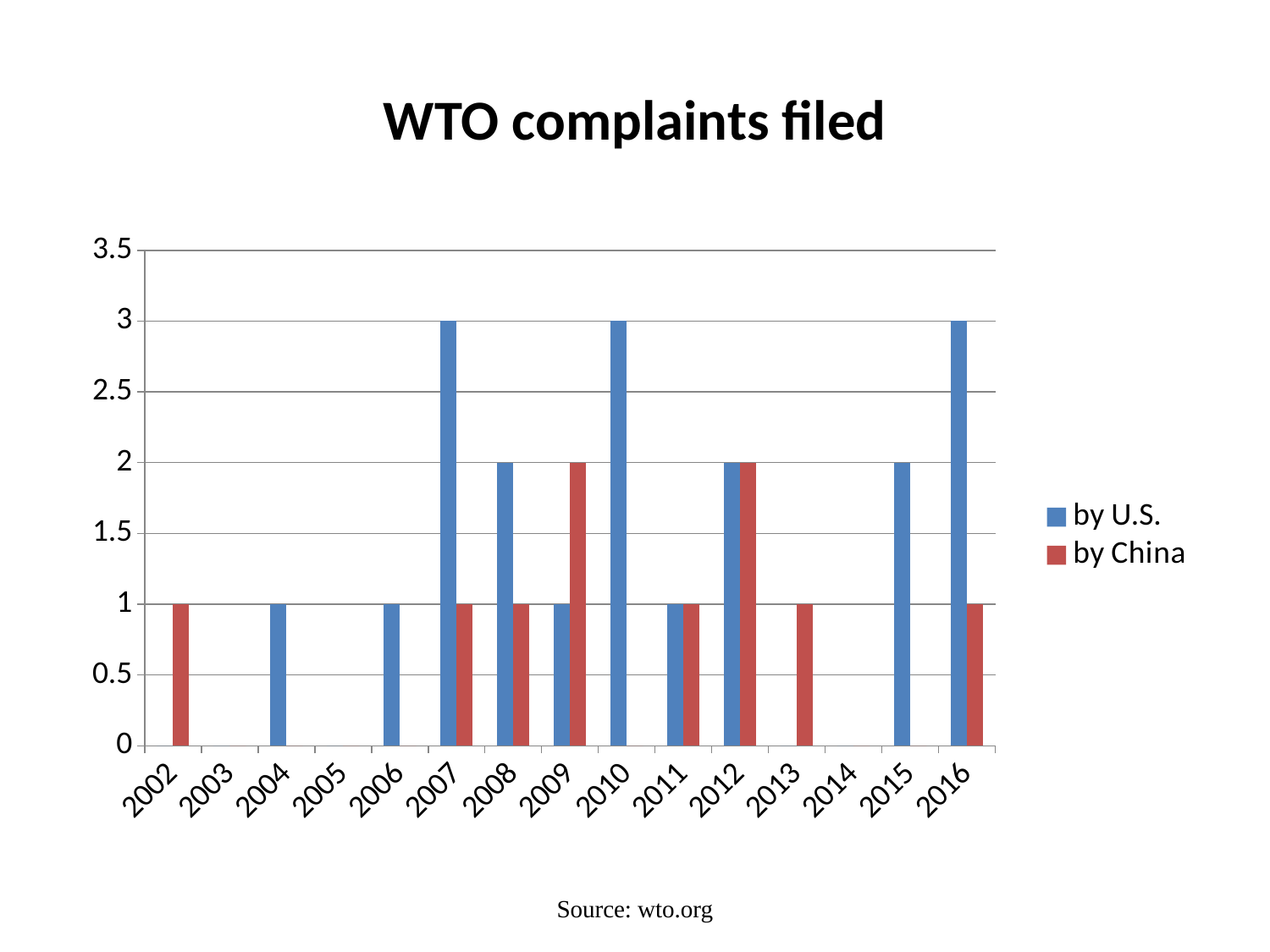
What is the title of the chart? WTO complaints filed What is the highest value reached by the 'by U.S.' series? 3 What is the value for 'by China' in 2002? 1 How many series does the legend list? 2 What is the value for 'by U.S.' in 2015? 2 How many years are shown on the x axis? 15 Is the value for 'by U.S.' in 2010 greater or less than 2.5? greater In 2009, which series has the larger value, 'by U.S.' or 'by China'? by China What kind of chart is shown on the slide? bar chart What is the value for 'by China' in 2009? 2 What is the value for 'by U.S.' in 2007? 3 What is the difference between the 'by U.S.' and 'by China' values in 2007? 2